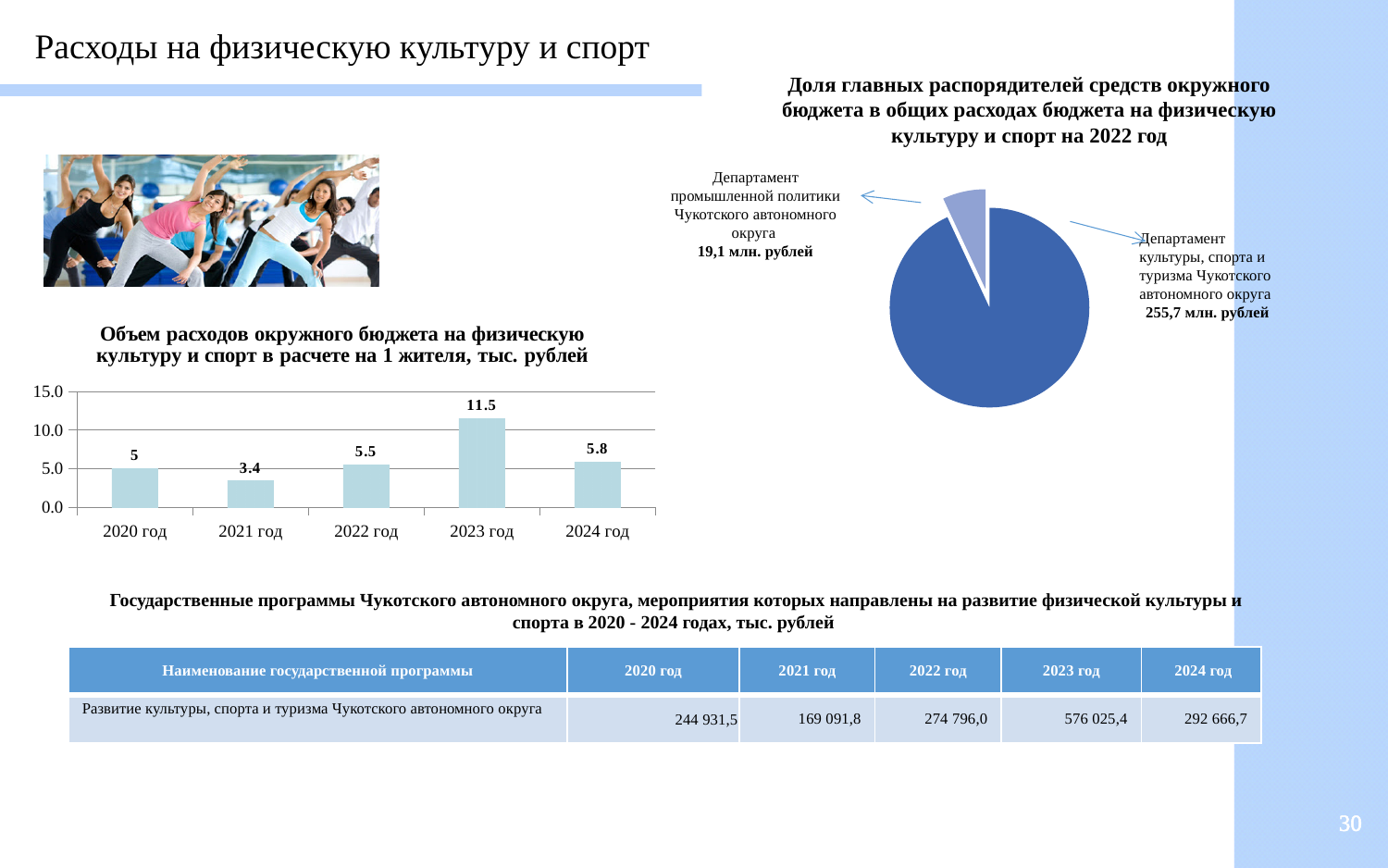
In the bar chart 'Объем расходов окружного бюджета на физическую культуру и спорт в расчете на 1 жителя', which year has the lowest value? 2021 год In the pie chart 'Доля главных распорядителей средств окружного бюджета в общих расходах бюджета на физическую культуру и спорт на 2022 год', what is the value for Департамент промышленной политики Чукотского автономного округа? 19,1 млн. рублей In the bar chart 'Объем расходов окружного бюджета на физическую культуру и спорт в расчете на 1 жителя', which year has the highest value? 2023 год In the bar chart 'Объем расходов окружного бюджета на физическую культуру и спорт в расчете на 1 жителя', what is the value for 2023 год? 11.5 In the bar chart 'Объем расходов окружного бюджета на физическую культуру и спорт в расчете на 1 жителя', what is the value for 2024 год? 5.8 In the bar chart 'Объем расходов окружного бюджета на физическую культуру и спорт в расчете на 1 жителя', which is larger: the value for 2020 год or 2022 год? 2022 год In the pie chart 'Доля главных распорядителей средств окружного бюджета в общих расходах бюджета на физическую культуру и спорт на 2022 год', which department has the larger share? Департамент культуры, спорта и туризма Чукотского автономного округа In the bar chart 'Объем расходов окружного бюджета на физическую культуру и спорт в расчете на 1 жителя', what is the difference between the values for 2023 год and 2024 год? 5.7 In the bar chart 'Объем расходов окружного бюджета на физическую культуру и спорт в расчете на 1 жителя', what is the value for 2021 год? 3.4 In the pie chart 'Доля главных распорядителей средств окружного бюджета в общих расходах бюджета на физическую культуру и спорт на 2022 год', what is the value for Департамент культуры, спорта и туризма Чукотского автономного округа? 255,7 млн. рублей What type of chart is 'Объем расходов окружного бюджета на физическую культуру и спорт в расчете на 1 жителя'? Bar chart How many years are shown in the bar chart 'Объем расходов окружного бюджета на физическую культуру и спорт в расчете на 1 жителя'? 5